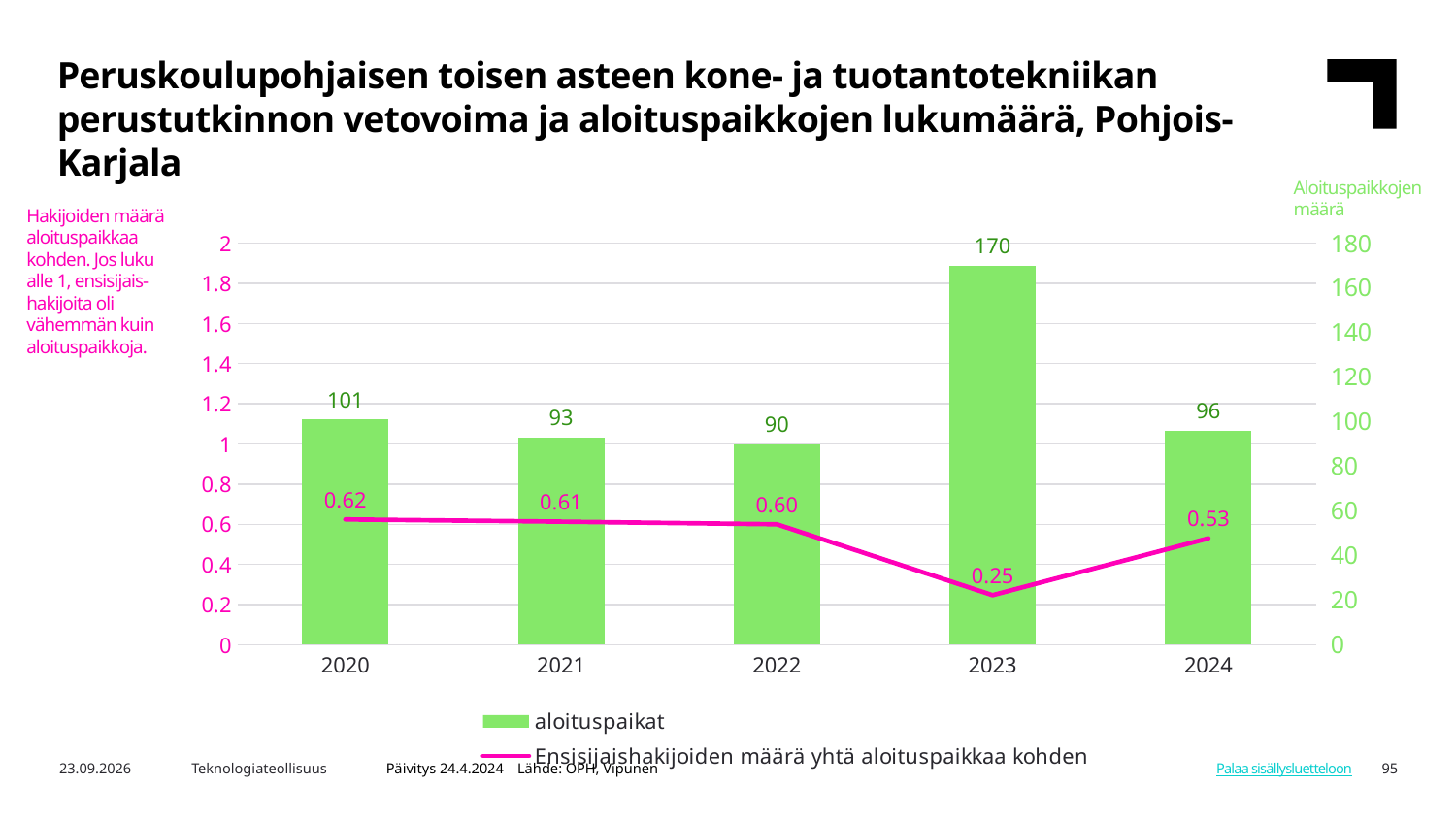
How many years are shown on the x axis? 5 How many series does the legend list? 2 What colour are the aloituspaikat bars? green Which year has the highest number of aloituspaikat? 2023 Which year has more aloituspaikat, 2020 or 2024? 2020 How many aloituspaikat were there in 2023? 170 Does the Ensisijaishakijoiden määrä yhtä aloituspaikkaa kohden line rise or fall from 2020 to 2023? fall What is the difference in aloituspaikat between 2023 and 2022? 80 Which year has the lowest value of Ensisijaishakijoiden määrä yhtä aloituspaikkaa kohden? 2023 What kind of chart is used for the aloituspaikat series? bar chart How many aloituspaikat were there in 2021? 93 What is the value of Ensisijaishakijoiden määrä yhtä aloituspaikkaa kohden in 2024? 0.53